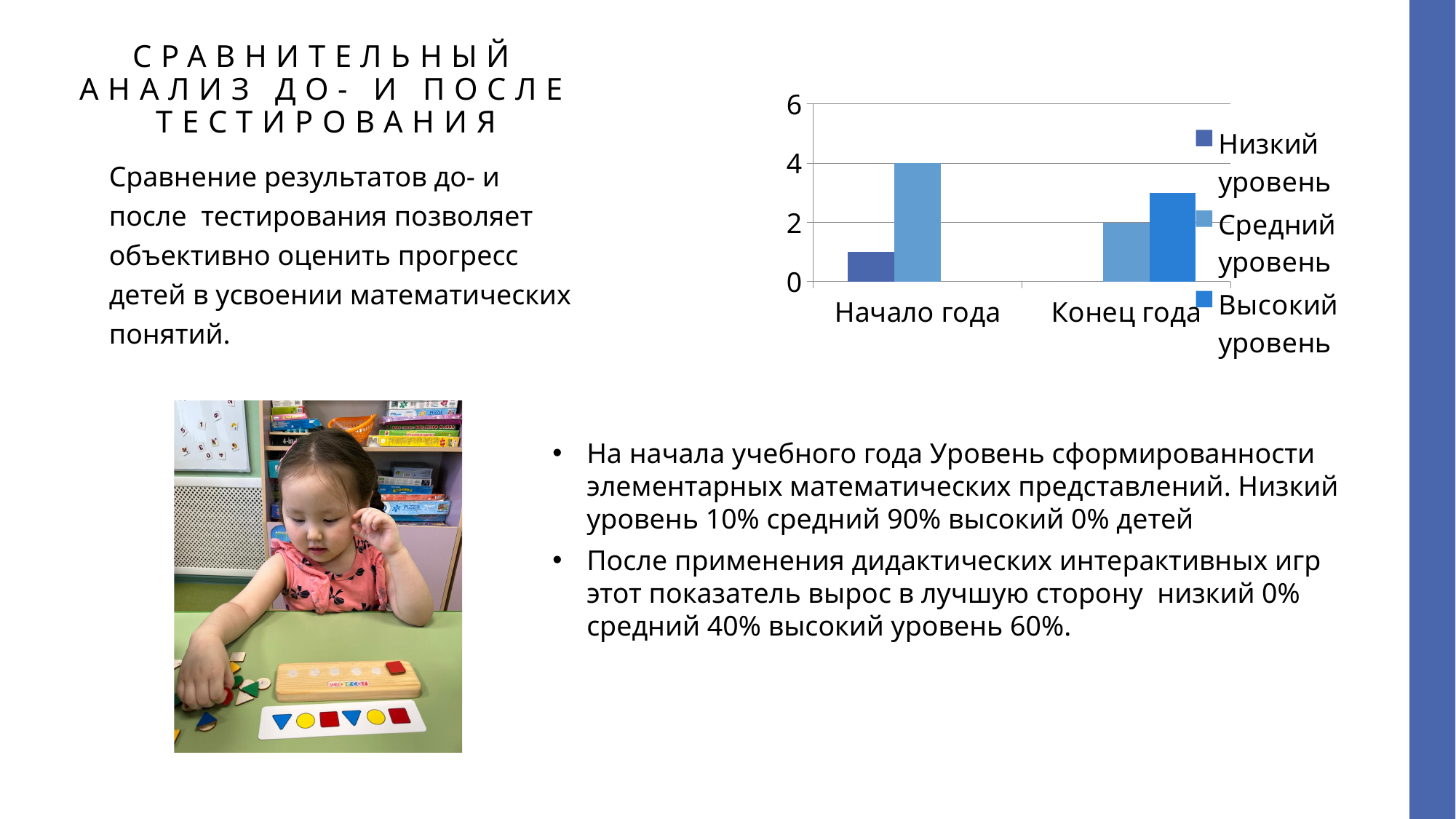
Which series has the highest value at Начало года? Средний уровень Is the value for Низкий уровень at Начало года greater or less than 2? less Does the value for Средний уровень rise or fall from Начало года to Конец года? fall What are the two category labels on the x axis of the chart? Начало года, Конец года Is the value for Высокий уровень at Конец года greater or less than 2? greater What is the difference between the Средний уровень values at Начало года and Конец года? 2 How many categories are shown on the x axis of the chart? 2 How many series does the chart legend list? 3 Which series has the highest value at Конец года? Высокий уровень What is the value for Средний уровень at Начало года? 4 What is the value for Средний уровень at Конец года? 2 What kind of chart is shown on the slide? Bar chart